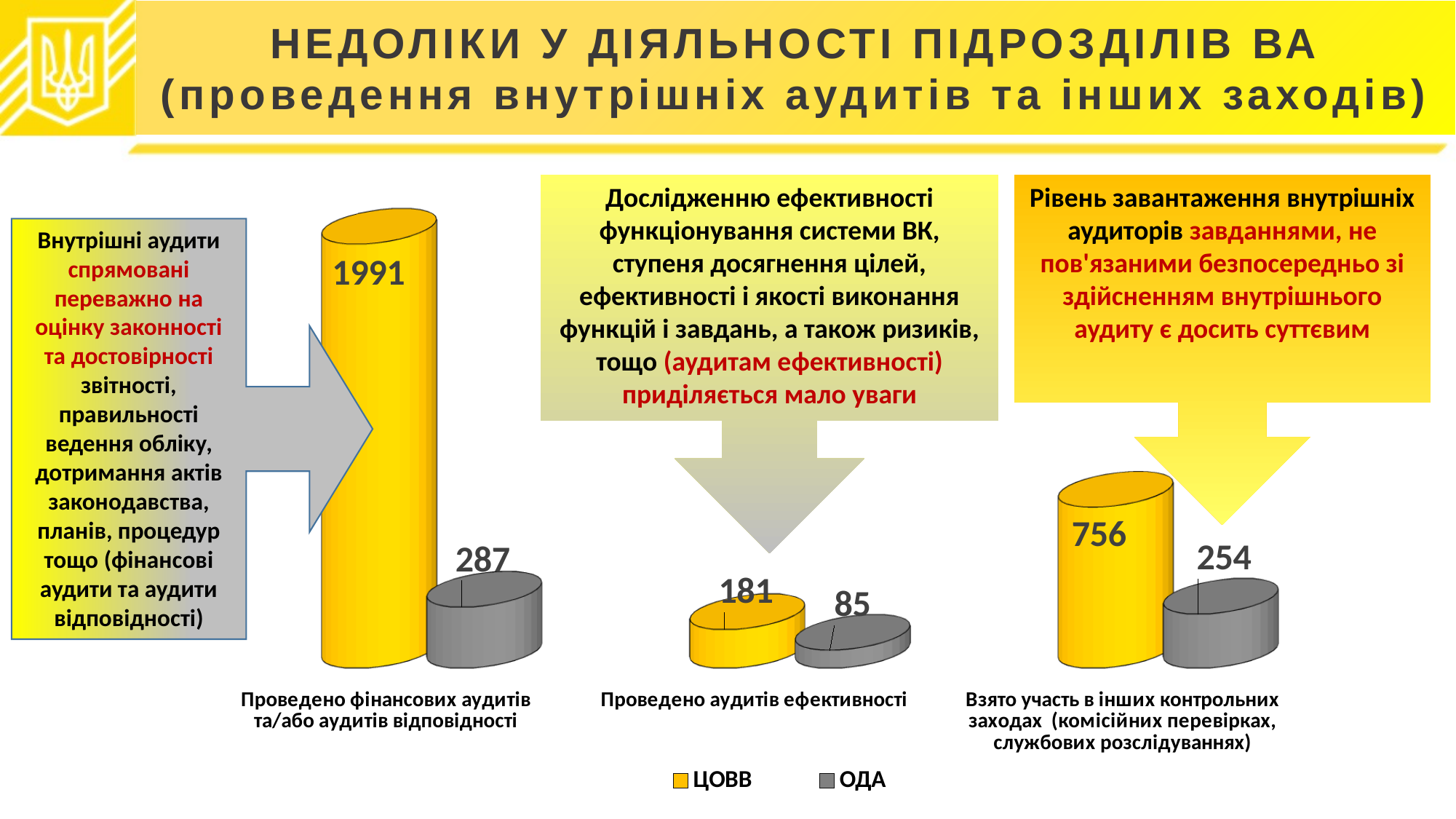
Which category has the lowest value for the ОДА series? Проведено аудитів ефективності What value is shown for ОДА in the category "Проведено фінансових аудитів та/або аудитів відповідності"? 287 What value is shown for ЦОВВ in the category "Проведено фінансових аудитів та/або аудитів відповідності"? 1991 What is the difference between the ЦОВВ and ОДА values in the category "Взято участь в інших контрольних заходах"? 502 What value is shown for ЦОВВ in the category "Взято участь в інших контрольних заходах"? 756 Which series is shown in grey in the legend? ОДА How many categories are shown on the chart? 3 What kind of chart is shown on the slide? Bar chart How many series does the legend list? 2 Which is larger in the category "Проведено аудитів ефективності": the ЦОВВ value or the ОДА value? ЦОВВ What value is shown for ОДА in the category "Проведено аудитів ефективності"? 85 Which category has the highest value for the ЦОВВ series? Проведено фінансових аудитів та/або аудитів відповідності